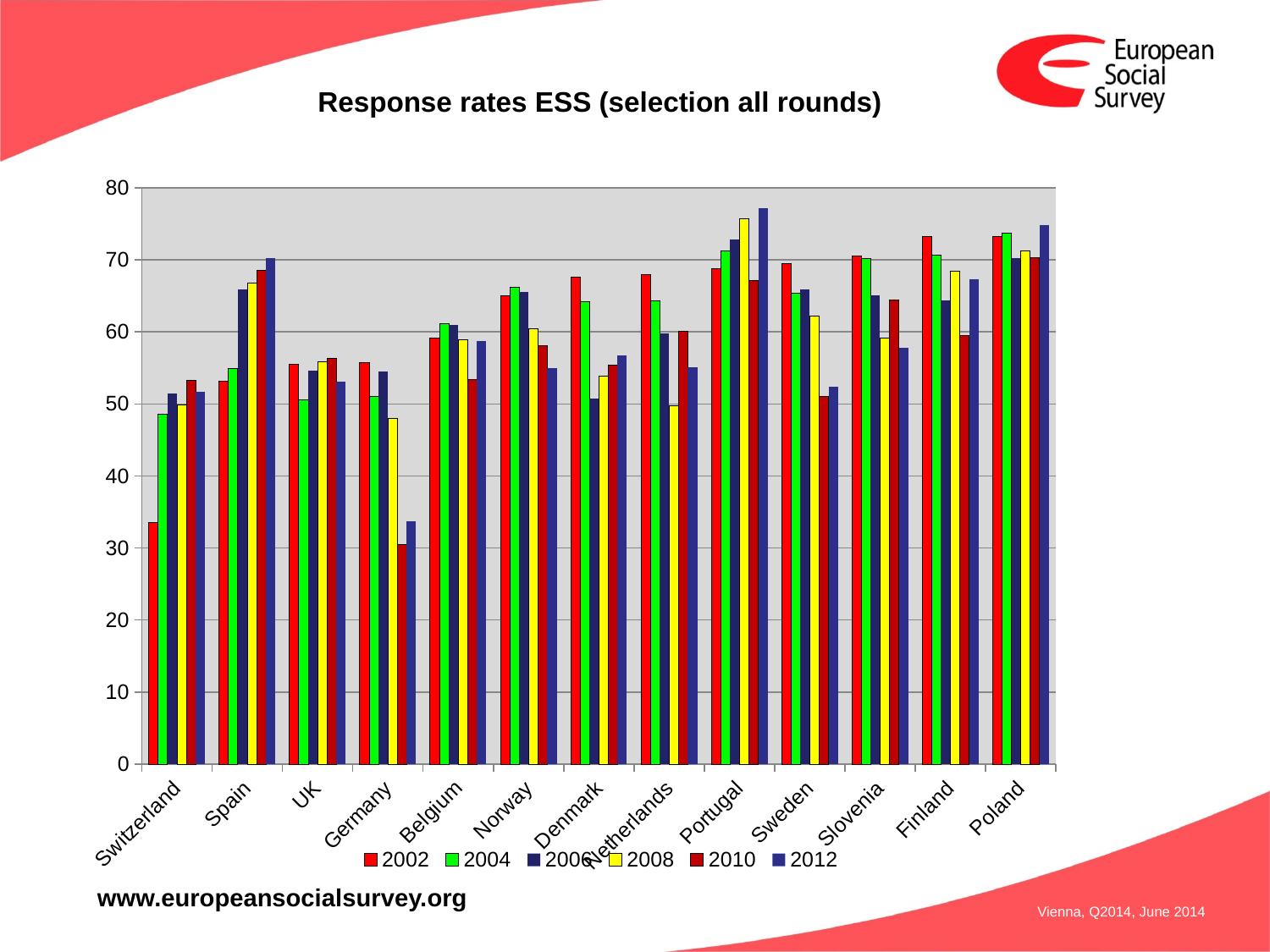
What kind of chart is shown on the slide? bar chart Do Spain's values rise or fall from 2002 to 2012? rise How many countries are shown on the x axis of the chart? 13 Is the 2012 value for Portugal greater or less than 70? greater How many series does the legend list? 6 Which country has the lowest single bar in the chart? Germany What is the title of the chart? Response rates ESS (selection all rounds) Is the 2002 value for Finland greater or less than 70? greater Is the 2010 value for Germany greater or less than 40? less Which country has the highest single bar in the chart? Portugal Which colour does the legend use for the 2008 series? yellow